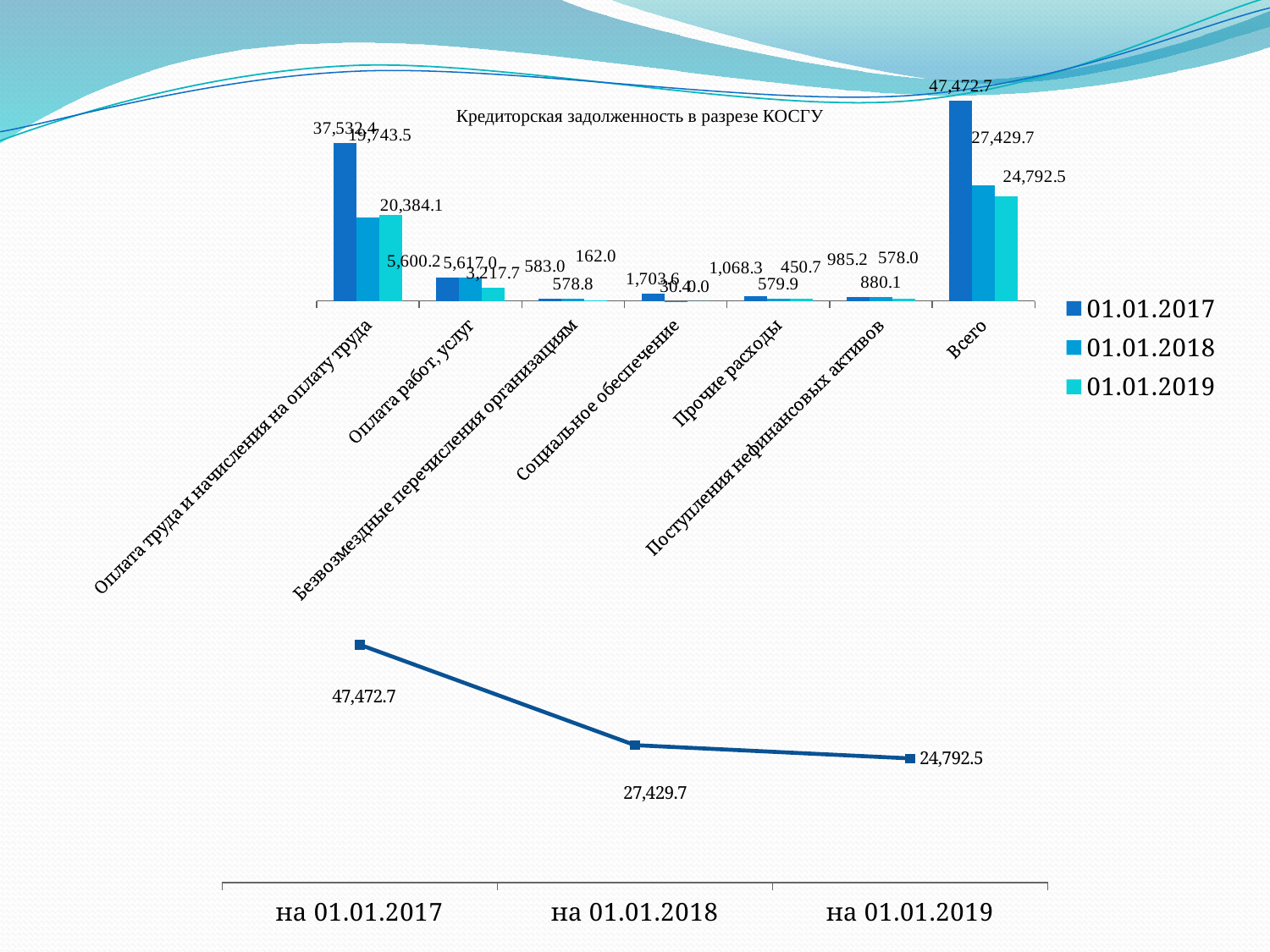
In the bottom line chart, do the values rise or fall from на 01.01.2017 to на 01.01.2019? fall In the bottom line chart, what is the value for на 01.01.2018? 27,429.7 How many categories are shown on the x axis of the top bar chart? 7 In the top bar chart, what is the value for Всего on 01.01.2017? 47,472.7 What kind of chart is the bottom chart on the slide? line chart In the bottom line chart, what is the difference between the values for на 01.01.2017 and на 01.01.2019? 22,680.2 How many series does the legend of the top bar chart list? 3 What is the title of the top bar chart? Кредиторская задолженность в разрезе КОСГУ In the top bar chart, which is larger for Оплата труда и начисления на оплату труда: the value for 01.01.2017 or for 01.01.2019? 01.01.2017 What kind of chart is the top chart on the slide? bar chart In the top bar chart, what is the value for Оплата труда и начисления на оплату труда on 01.01.2019? 20,384.1 In the top bar chart, what is the value for Оплата работ, услуг on 01.01.2019? 3,217.7